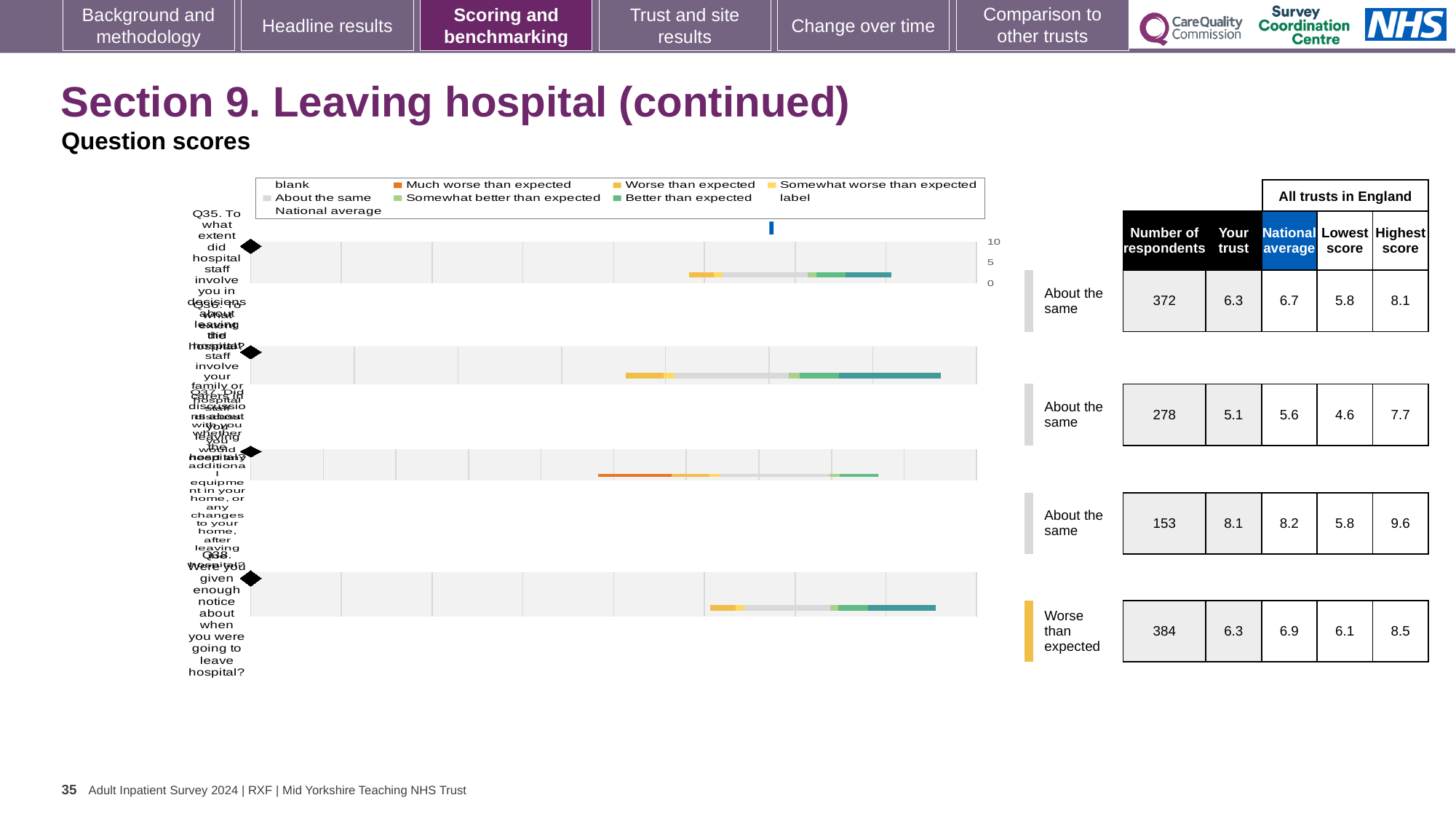
What is the difference between the national average and the 'Your trust' score for Q38 in the table beside the chart? 0.6 What kind of chart is used to show the question scores on this slide? bar chart Which benchmark category is assigned to Q38 in the chart? Worse than expected Which question row has the lowest number of respondents in the table beside the chart? Q37 What is the national average for Q36 in the table beside the chart? 5.6 Which legend entry is shown in orange in the chart's legend? Much worse than expected What is the highest score across all trusts in England for Q37 in the table beside the chart? 9.6 How many survey questions (rows) are plotted in the chart? 4 What is the 'Your trust' score for Q35 in the table beside the chart? 6.3 How many respondents answered Q38 according to the table beside the chart? 384 Is the 'Your trust' score for Q36 larger or smaller than the 'Your trust' score for Q35 in the table beside the chart? smaller Which question row has the highest 'Your trust' score in the table beside the chart? Q37